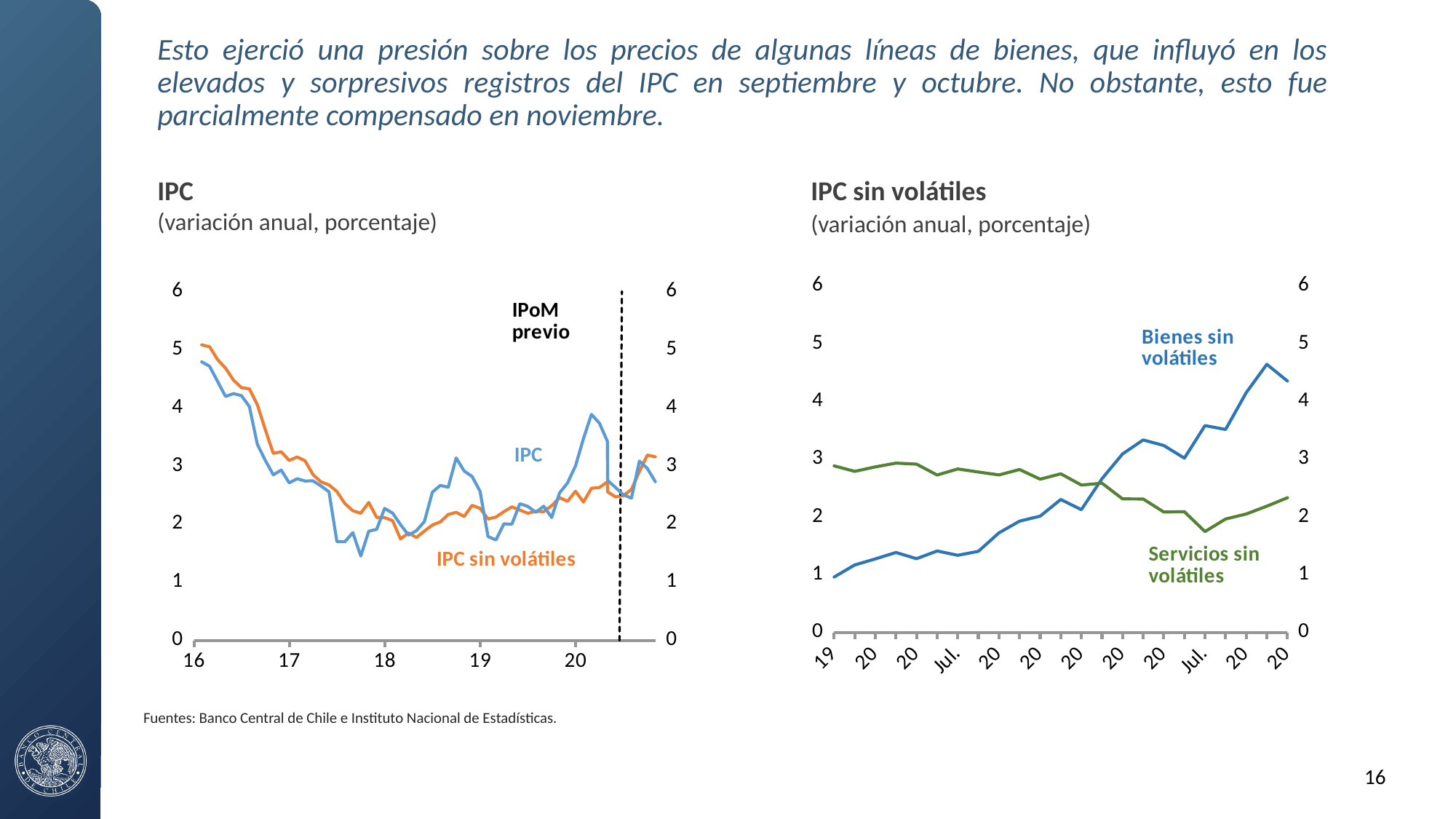
On the 'IPC' chart on the left, what does the vertical dashed line mark? IPoM previo On the 'IPC sin volátiles' chart on the right, is the final value of Bienes sin volátiles greater or less than 4? greater What kind of chart is the 'IPC sin volátiles' chart on the right? line chart On the 'IPC sin volátiles' chart on the right, does Bienes sin volátiles rise or fall over the period shown? rise On the 'IPC sin volátiles' chart on the right, which series is higher at the start of 2019, Bienes sin volátiles or Servicios sin volátiles? Servicios sin volátiles What kind of chart is the 'IPC' chart on the left? line chart On the 'IPC sin volátiles' chart on the right, is the value of Bienes sin volátiles at the start of 2019 greater or less than 2? less On the 'IPC sin volátiles' chart on the right, which series is higher at the end of the period, Bienes sin volátiles or Servicios sin volátiles? Bienes sin volátiles How many series are plotted on the 'IPC sin volátiles' chart on the right? 2 On the 'IPC' chart on the left, does the IPC series rise or fall between 2016 and 2018? fall On the 'IPC' chart on the left, is the value of IPC at the start of 2016 greater or less than 4? greater How many series are plotted on the 'IPC' chart on the left? 2